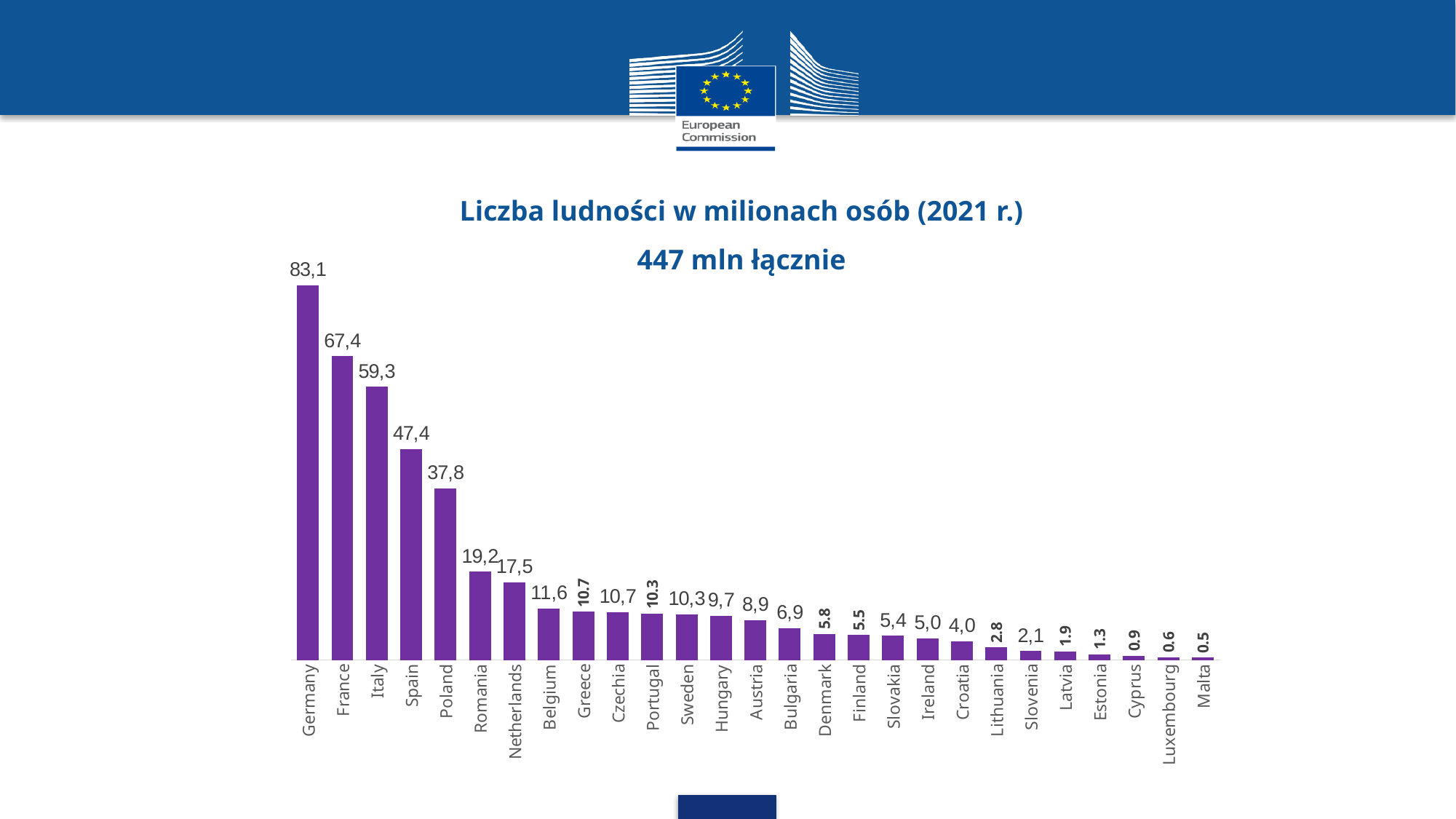
What is the value shown for Malta? 0.5 How many countries are shown in the chart? 27 Which country has the lowest population in the chart? Malta What is the difference between the values for Germany and France? 15,7 What is the population value shown for Poland? 37,8 What is the value shown for Greece? 10.7 Which country has the highest population in the chart? Germany What total population is stated in the chart's subtitle? 447 mln łącznie What is the population value shown for Germany? 83,1 Which has a larger population, Romania or the Netherlands? Romania What is the difference between the values for Spain and Poland? 9,6 What kind of chart is shown on the slide? Bar chart